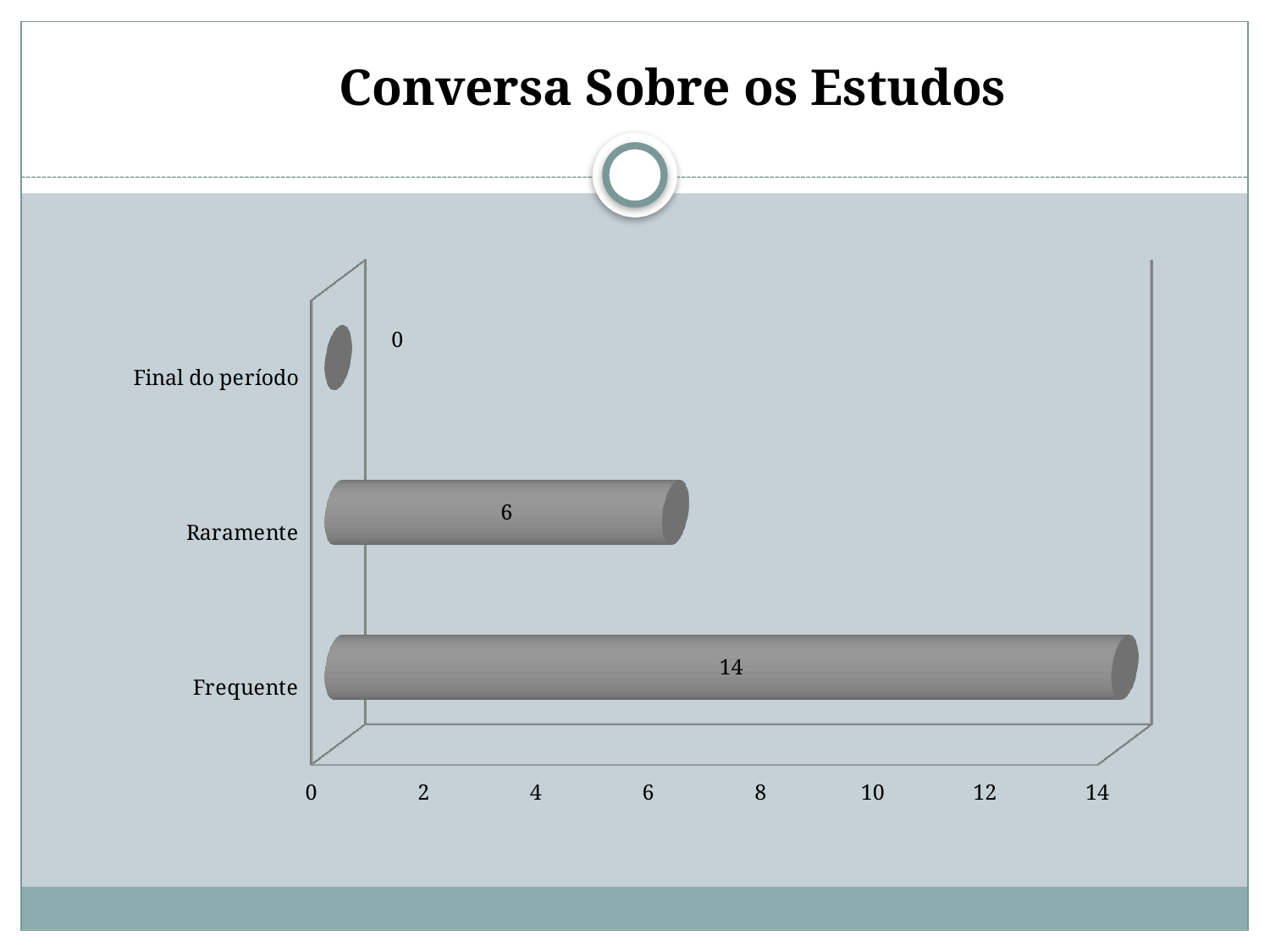
What is the value for Frequente? 14 What is the difference between the values for Frequente and Raramente? 8 What is the value for Final do período? 0 What is the title of the slide? Conversa Sobre os Estudos How many categories are shown in the chart? 3 What kind of chart is shown on the slide? bar chart Which category has the lowest value? Final do período What is the value for Raramente? 6 Is the value for Frequente greater or less than 10? greater What is the total of the values for all three categories? 20 Which is larger, the value for Raramente or the value for Final do período? Raramente Which category has the highest value? Frequente